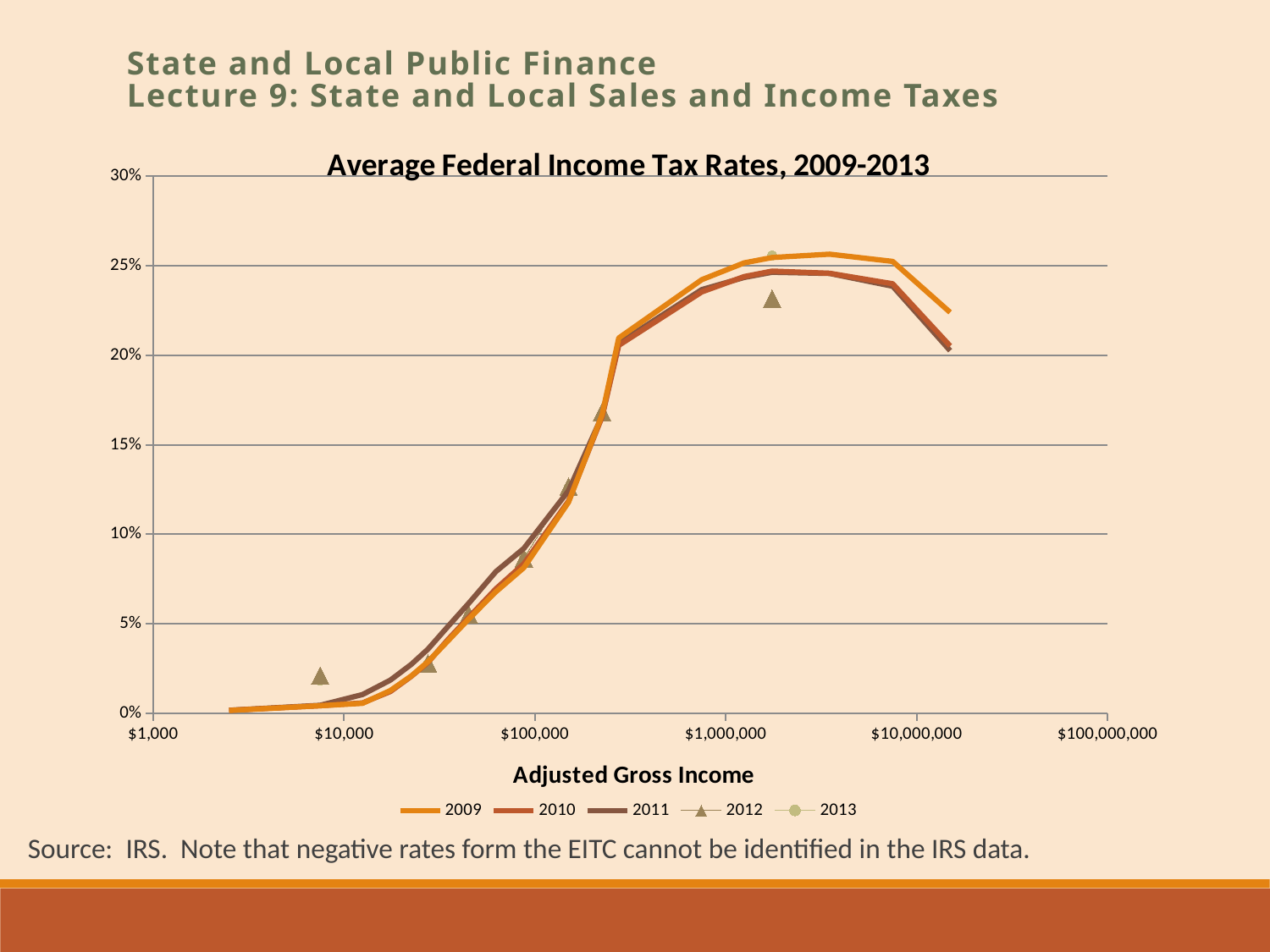
At the highest income level plotted (just above $10,000,000), which series has the higher average tax rate, 2009 or 2011? 2009 What is the title of the chart? Average Federal Income Tax Rates, 2009-2013 Do the average tax rates rise or fall as adjusted gross income increases from about $3,000,000 to the highest income plotted? fall What kind of chart is shown on the slide? line chart What is the label on the x axis of the chart? Adjusted Gross Income Is the highest point of the 2009 line greater or less than 25%? greater Is the 2009 average tax rate at $100,000 of adjusted gross income greater or less than 10%? less How many series does the legend list? 5 Do the average tax rates rise or fall as adjusted gross income increases from $10,000 to $1,000,000? rise Is the 2009 average tax rate at $10,000 of adjusted gross income greater or less than 5%? less